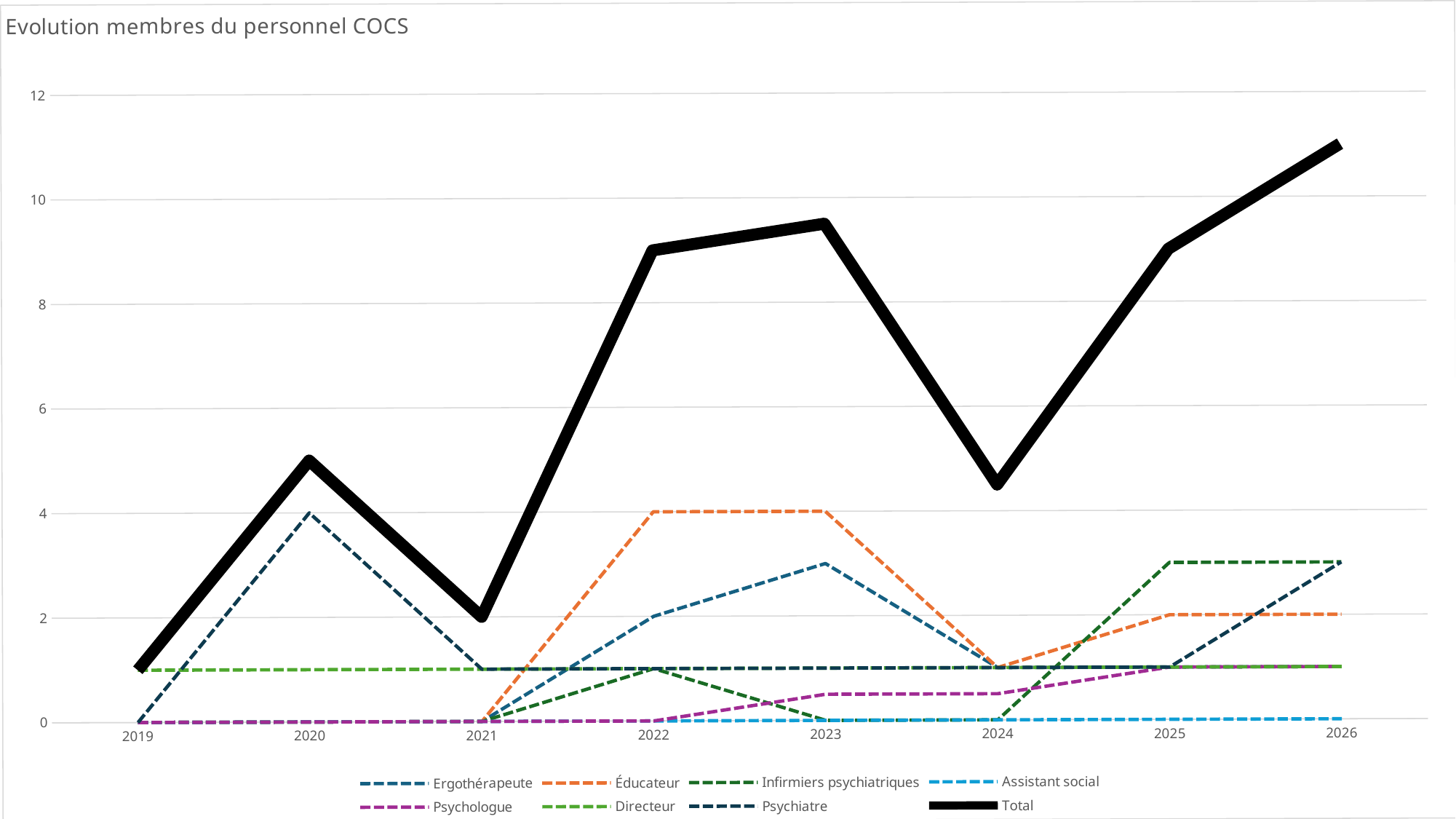
What is the title of the chart? Evolution membres du personnel COCS What type of chart is shown on the slide? line chart In which year is the Total series at its lowest? 2019 What is the value for Éducateur in 2022? 4 How many years are shown on the x axis? 8 How many series does the legend list? 8 Is the value of the Total series in 2026 greater or less than 10? greater In which year is the Total series at its highest? 2026 Which is larger for the Total series: the value in 2022 or the value in 2024? 2022 What is the value of the Total series in 2021? 2 What is the value for Ergothérapeute in 2020? 0 Is the value of the Total series in 2024 greater or less than 6? less